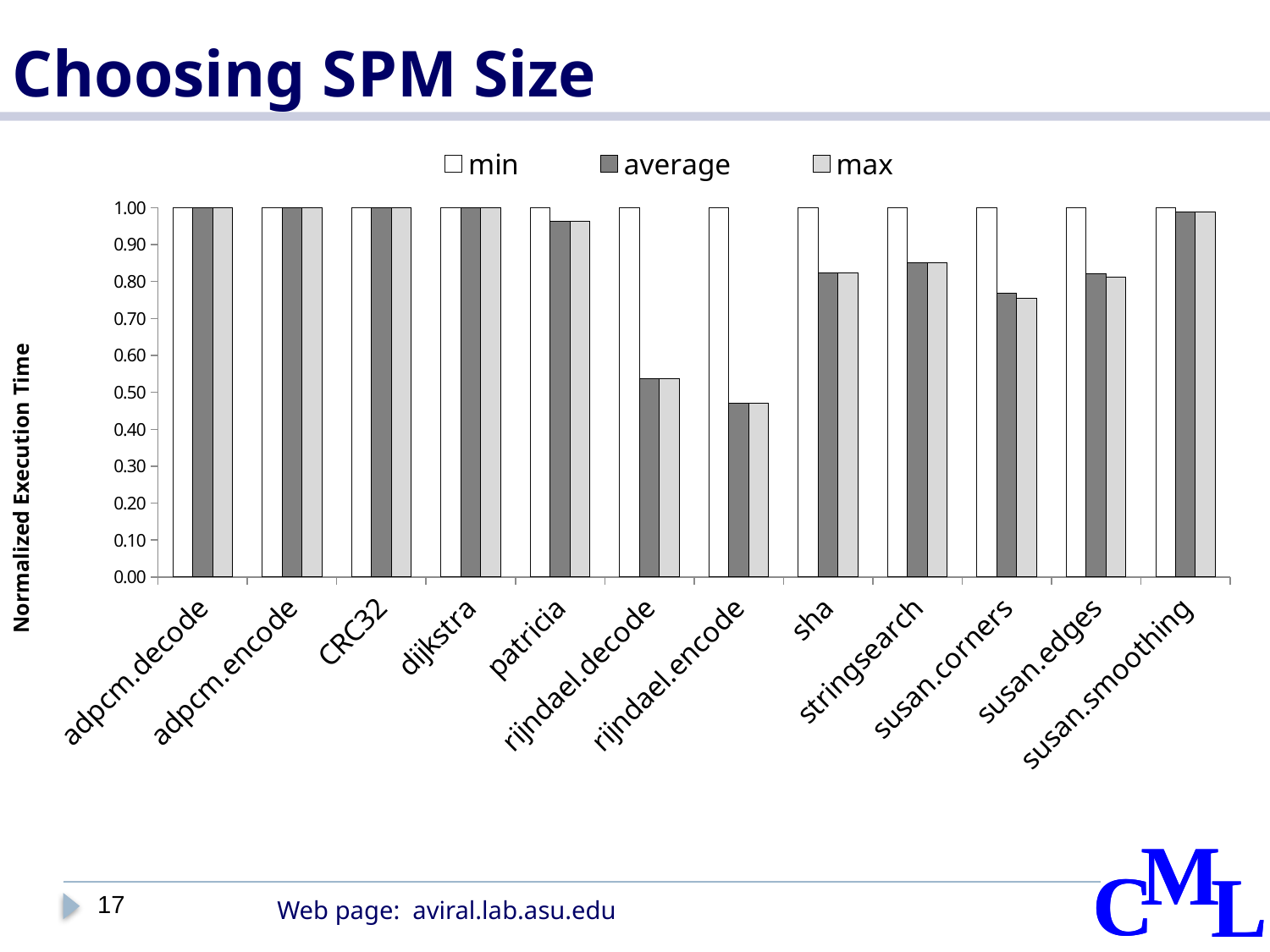
Which benchmark has the lowest average normalized execution time? rijndael.encode Is the average value for susan.corners greater or less than 0.80? less Is the average value for rijndael.decode greater or less than 0.60? less How many benchmark categories are shown on the x axis? 12 What kind of chart is shown on the slide? bar chart What is the min value for rijndael.decode? 1.00 What is the label of the y axis? Normalized Execution Time What are the three series named in the legend? min, average, max Is the max value for sha greater or less than 0.80? greater Which is larger, the average value for stringsearch or the average value for rijndael.encode? stringsearch What is the average value for CRC32? 1.00 How many series does the legend list? 3